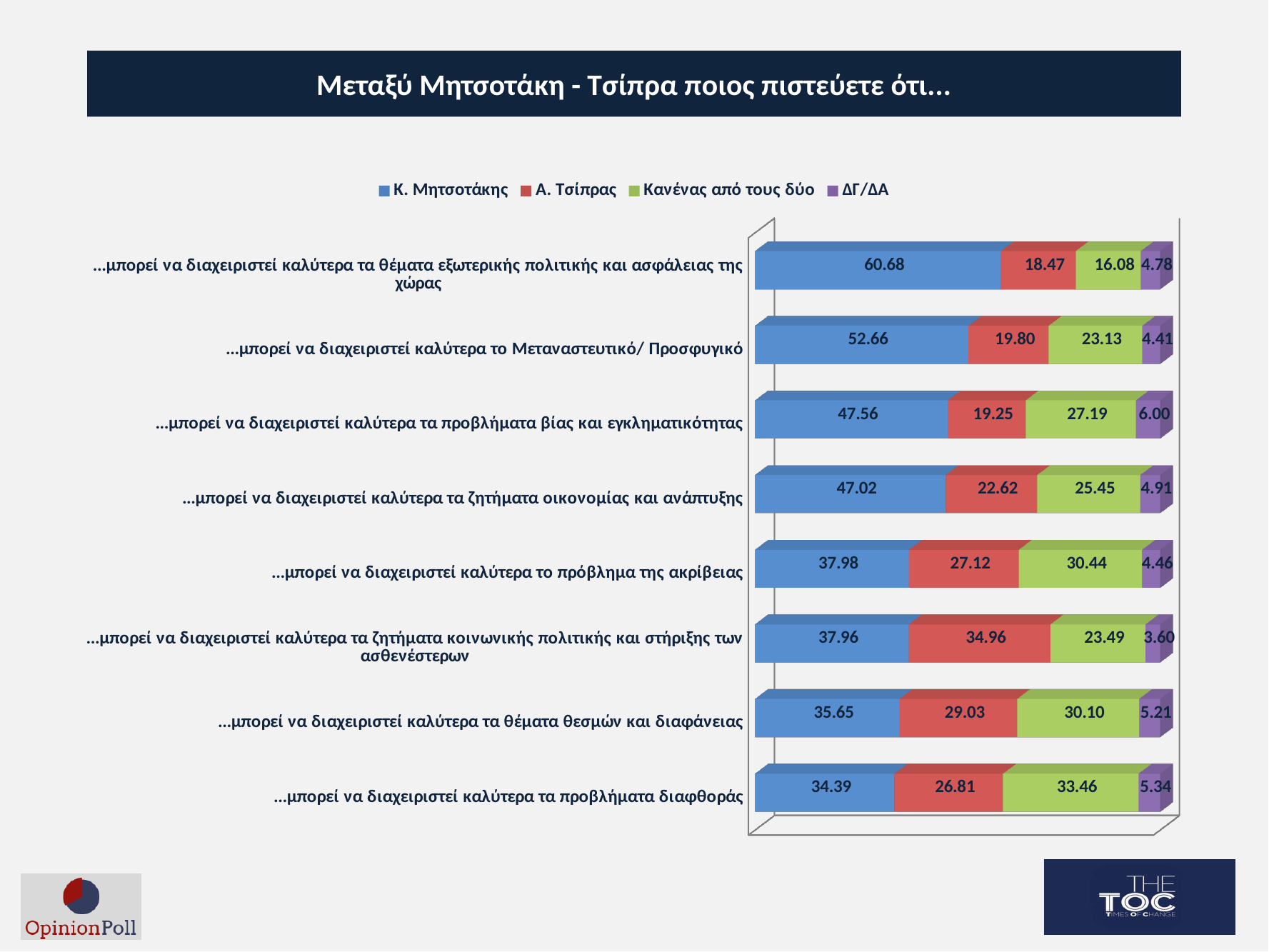
In which category does Α. Τσίπρας have the highest value? ...μπορεί να διαχειριστεί καλύτερα τα ζητήματα κοινωνικής πολιτικής και στήριξης των ασθενέστερων What is the value for Κ. Μητσοτάκης in the category "...μπορεί να διαχειριστεί καλύτερα τα θέματα εξωτερικής πολιτικής και ασφάλειας της χώρας"? 60.68 What kind of chart is shown on the slide? Stacked bar chart In which category does Κ. Μητσοτάκης have the lowest value? ...μπορεί να διαχειριστεί καλύτερα τα προβλήματα διαφθοράς What is the value for Κανένας από τους δύο in the category "...μπορεί να διαχειριστεί καλύτερα τα προβλήματα διαφθοράς"? 33.46 What is the value for Α. Τσίπρας in the category "...μπορεί να διαχειριστεί καλύτερα το πρόβλημα της ακρίβειας"? 27.12 What is the difference between the Κ. Μητσοτάκης and Α. Τσίπρας values in the category "...μπορεί να διαχειριστεί καλύτερα τα θέματα εξωτερικής πολιτικής και ασφάλειας της χώρας"? 42.21 How many series does the legend list? 4 In which category does Κ. Μητσοτάκης have the highest value? ...μπορεί να διαχειριστεί καλύτερα τα θέματα εξωτερικής πολιτικής και ασφάλειας της χώρας How many categories are shown in the chart? 8 In the category "...μπορεί να διαχειριστεί καλύτερα τα θέματα θεσμών και διαφάνειας", which is larger: the value for Α. Τσίπρας or for Κανένας από τους δύο? Κανένας από τους δύο What is the value for ΔΓ/ΔΑ in the category "...μπορεί να διαχειριστεί καλύτερα τα προβλήματα βίας και εγκληματικότητας"? 6.00